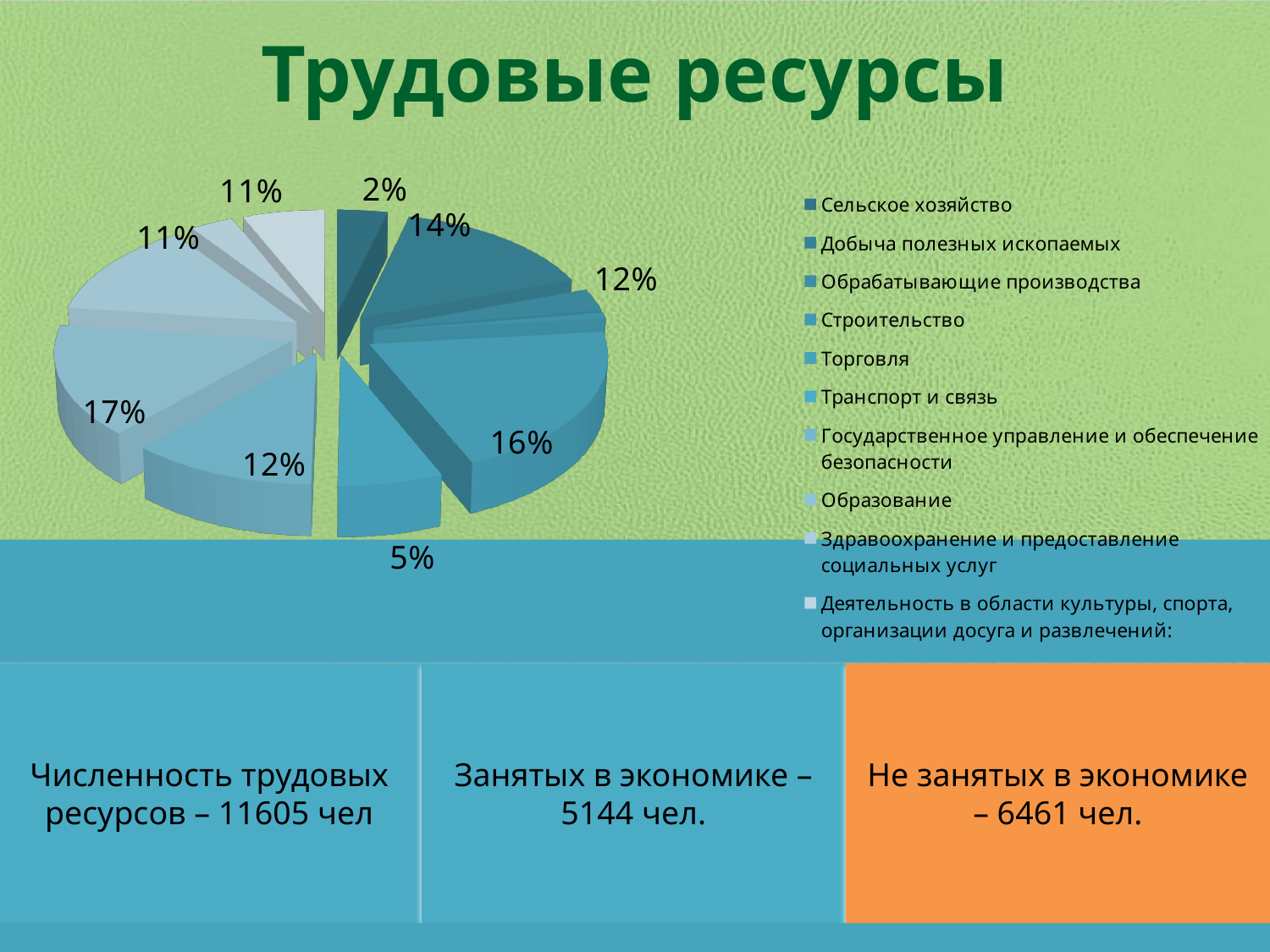
What percentage is shown for the darkest slice at the top of the pie chart (Сельское хозяйство)? 2% How many slices of the pie chart are labelled 11%? 2 What is the difference between the largest labelled slice (17%) and the slice labelled 5%? 12% What is the combined share of the two slices labelled 11%? 22% Which is larger: the slice labelled 16% or the slice labelled 14%? 16% What kind of chart is shown on the slide? pie chart What is the title of the slide containing the pie chart? Трудовые ресурсы Which legend entry is listed first in the pie chart's legend? Сельское хозяйство What is the smallest percentage labelled on any slice of the pie chart? 2% How many slices of the pie chart are labelled 12%? 2 How many categories does the legend of the pie chart list? 10 What is the largest percentage labelled on any slice of the pie chart? 17%